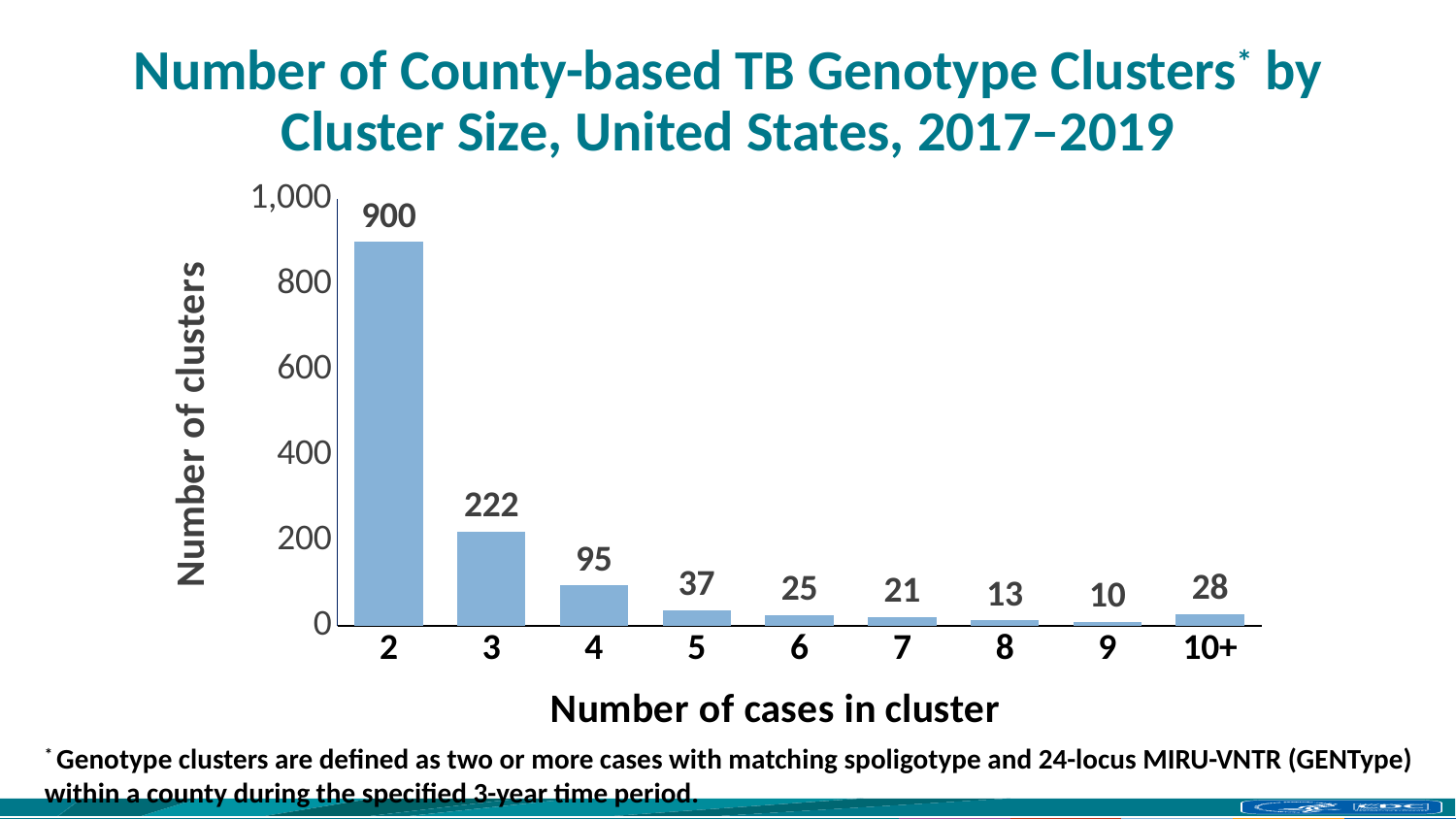
How many clusters had 2 cases? 900 Do the number of clusters generally rise or fall as cluster size increases from 2 to 9? Fall How many clusters had 10 or more cases (the 10+ category)? 28 Which has more clusters: cluster size 5 or cluster size 10+? 5 What is the label of the y axis? Number of clusters Which cluster size has the highest number of clusters? 2 What kind of chart is shown on the slide? Bar chart What is the difference between the number of clusters with 2 cases and the number with 3 cases? 678 Which cluster size has the lowest number of clusters? 9 How many cluster-size categories are shown on the x axis? 9 Is the number of clusters with 3 cases greater or less than 200? greater What is the number of clusters with 4 cases? 95